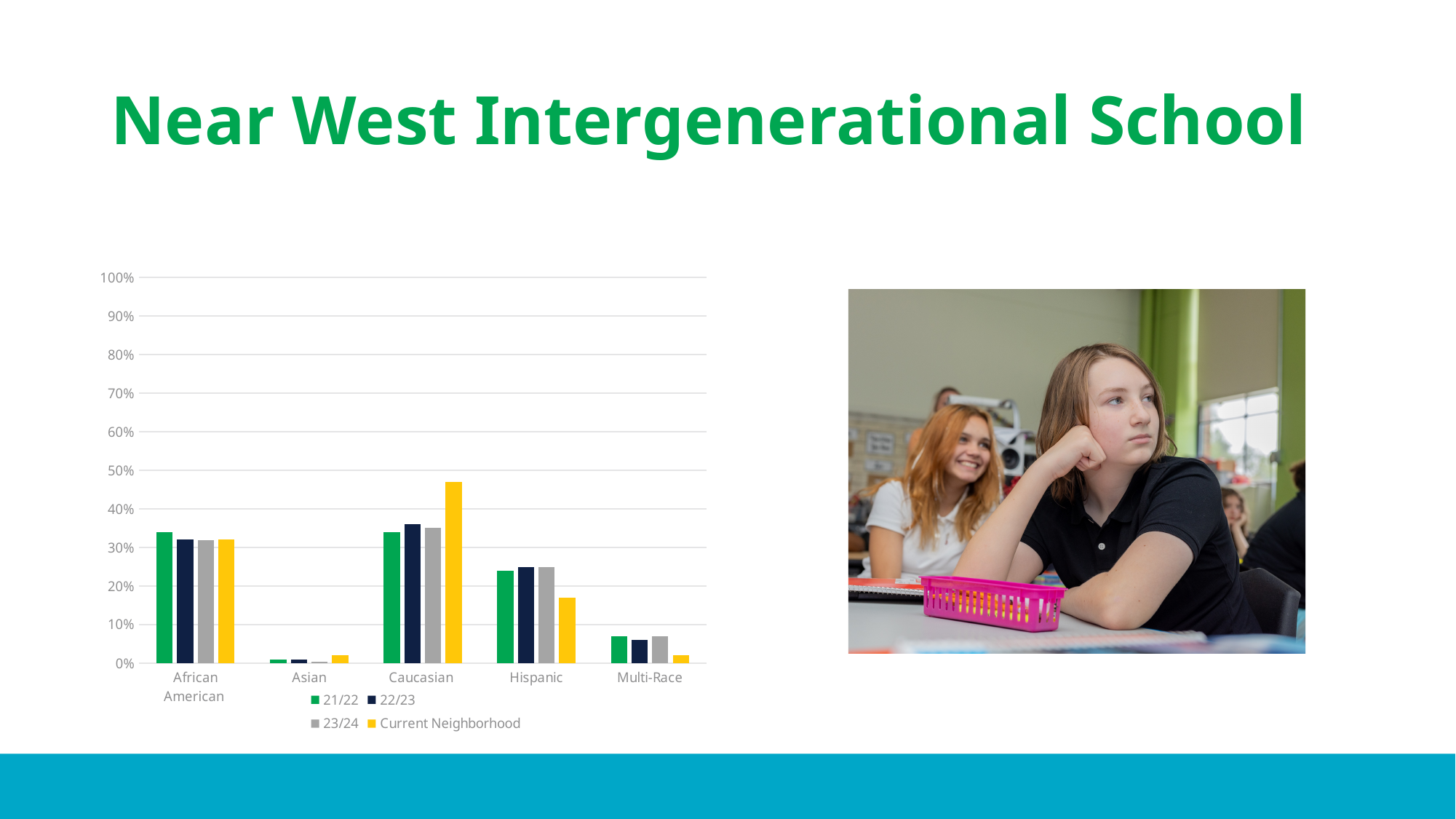
What kind of chart is shown on the slide? bar chart What colour represents the Current Neighborhood series in the chart? yellow What are the four series listed in the chart's legend? 21/22, 22/23, 23/24, Current Neighborhood Is the Current Neighborhood value for Caucasian greater or less than 40%? greater Which category has the highest Current Neighborhood value? Caucasian For Hispanic, which is larger: the 23/24 value or the Current Neighborhood value? 23/24 Which is larger: the Current Neighborhood value for Caucasian or for African American? Caucasian Is the 21/22 value for Hispanic greater or less than 20%? greater Which category has the lowest 21/22 value? Asian Is the 21/22 value for Multi-Race greater or less than 10%? less How many categories are shown on the x axis of the chart? 5 How many series does the chart's legend list? 4